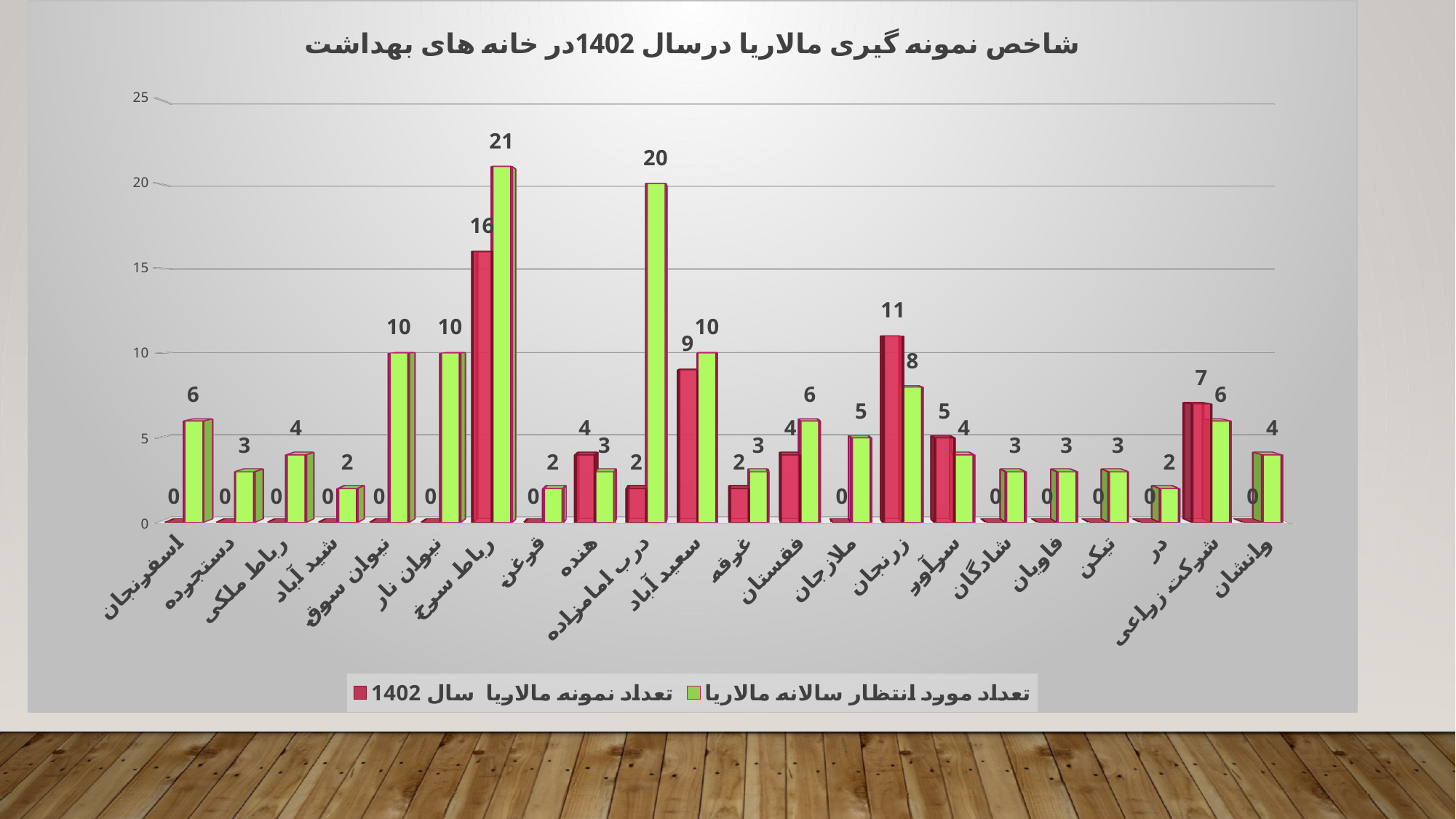
What is the value of the green bar for درب امامزاده? 20 What is the value of the green bar (تعداد مورد انتظار سالانه مالاریا) for رباط سرخ? 21 What is the value of the red bar for شرکت زراعی? 7 Which category has the highest green bar (تعداد مورد انتظار سالانه مالاریا)? رباط سرخ How many series does the legend list? 2 For زرنجان, which is larger: the red bar or the green bar? the red bar What is the value of the red bar (تعداد نمونه مالاریا سال 1402) for زرنجان? 11 What type of chart is shown on the slide? bar chart What is the difference between the green and red bars for رباط سرخ? 5 Which category has the highest red bar (تعداد نمونه مالاریا سال 1402)? رباط سرخ What is the difference between the green bar and the red bar for درب امامزاده? 18 How many categories (health houses) are shown on the x axis? 22